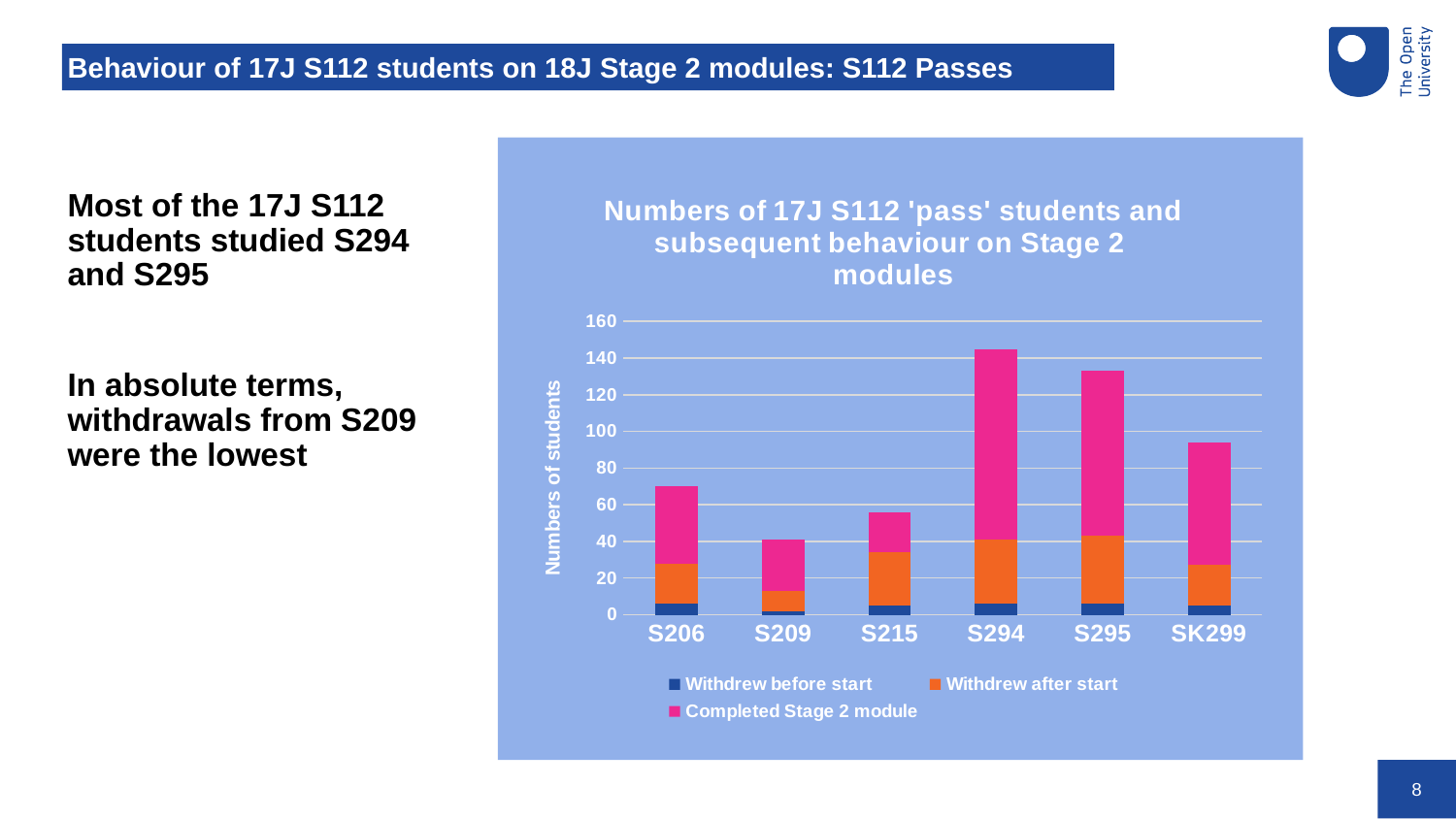
How many Stage 2 modules (categories) are shown on the x axis of the chart? 6 Which module has the shortest bar (the fewest 17J S112 'pass' students) in the chart? S209 Is the total bar height for S294 greater or less than 120? greater Is the total bar height for S295 greater or less than 120? greater Which bar is taller, S295 or SK299? S295 What kind of chart is shown on the slide? Stacked bar chart What is the label on the vertical axis of the chart? Numbers of students Is the total bar height for S209 greater or less than 60? less How many series does the chart's legend list? 3 Which bar is taller, S206 or S215? S206 Which module has the tallest bar (the most 17J S112 'pass' students) in the chart? S294